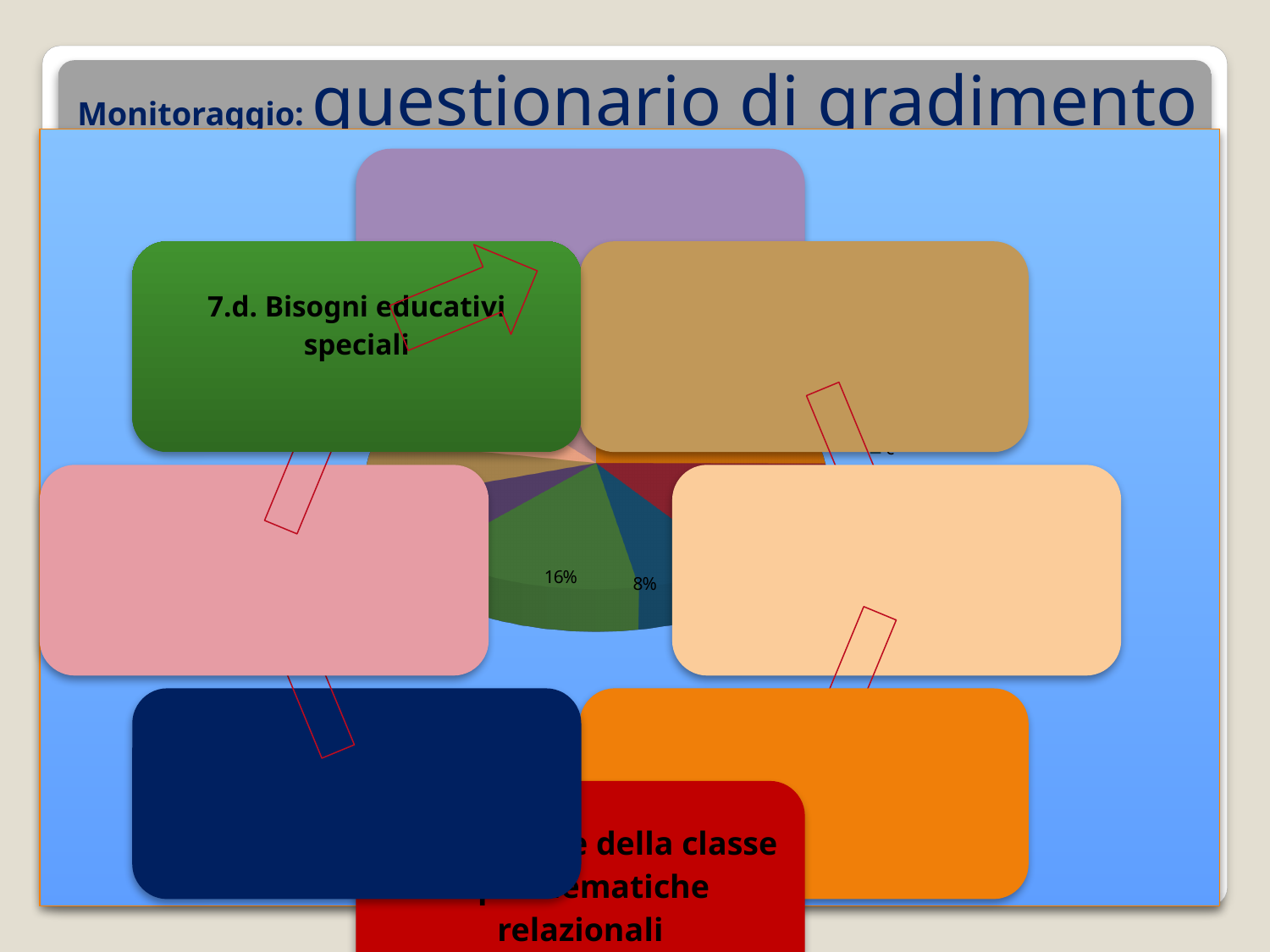
Is the pie chart drawn in 3D or flat 2D? 3D What percentage label is printed on the green slice of the pie chart? 16% What percentage label is printed on the dark teal slice of the pie chart? 8% Which is larger, the slice labelled 16% or the slice labelled 8%? the slice labelled 16% What kind of chart is partially visible on the slide? pie chart What is the difference between the two visible percentage labels on the pie chart, 16% and 8%? 8%